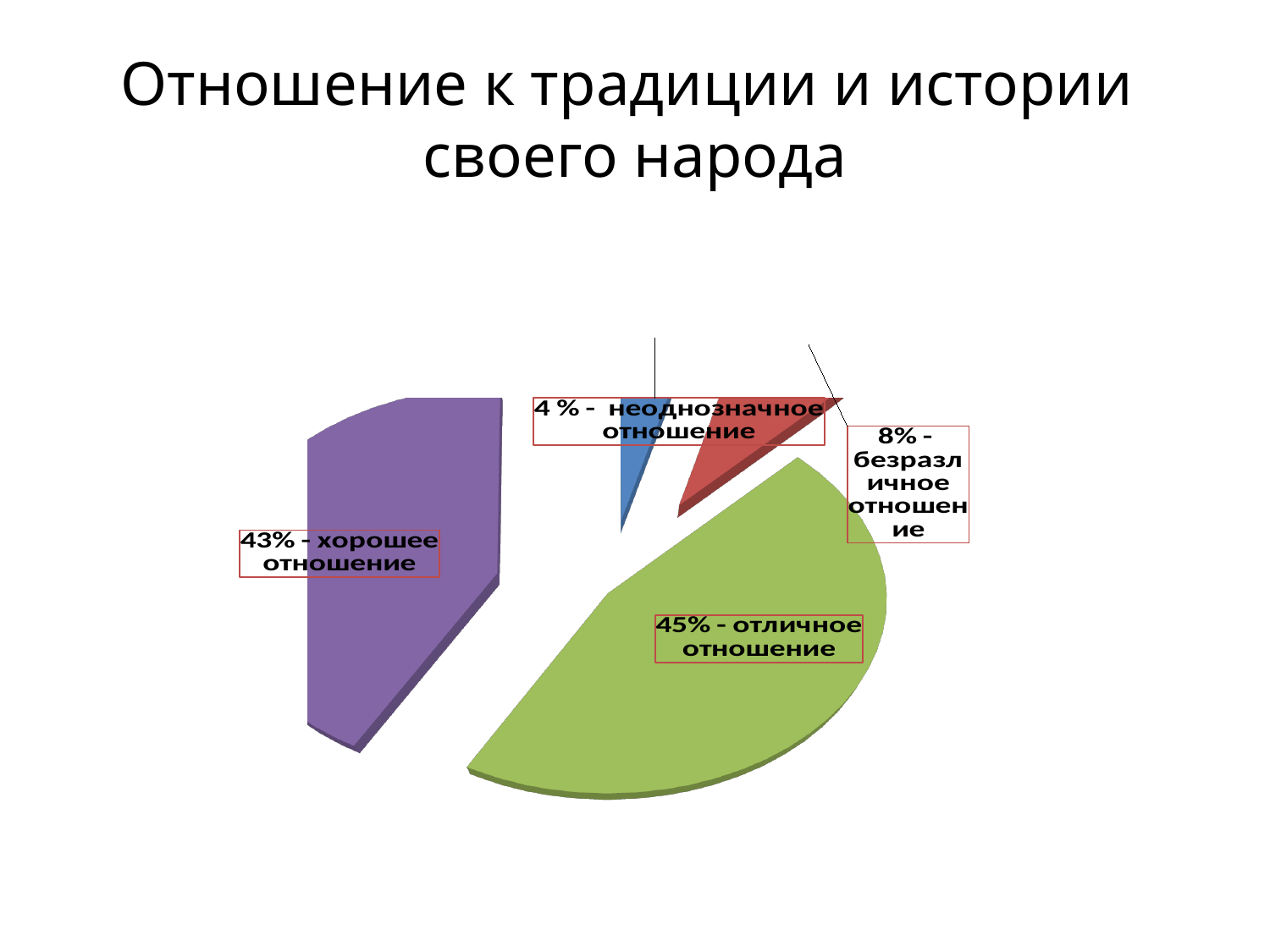
What is the title of the chart on the slide? Отношение к традиции и истории своего народа What share of the pie is labelled "хорошее отношение"? 43% What colour is the slice for "хорошее отношение"? Purple What kind of chart is shown on the slide? Pie chart What share of the pie is labelled "отличное отношение"? 45% What share of the pie is labelled "неоднозначное отношение"? 4% How many slices does the pie chart have? 4 Which is larger: the share for "безразличное отношение" or the share for "неоднозначное отношение"? безразличное отношение Which category has the largest slice of the pie? отличное отношение Which category has the smallest slice of the pie? неоднозначное отношение What is the difference in percentage points between "отличное отношение" and "хорошее отношение"? 2